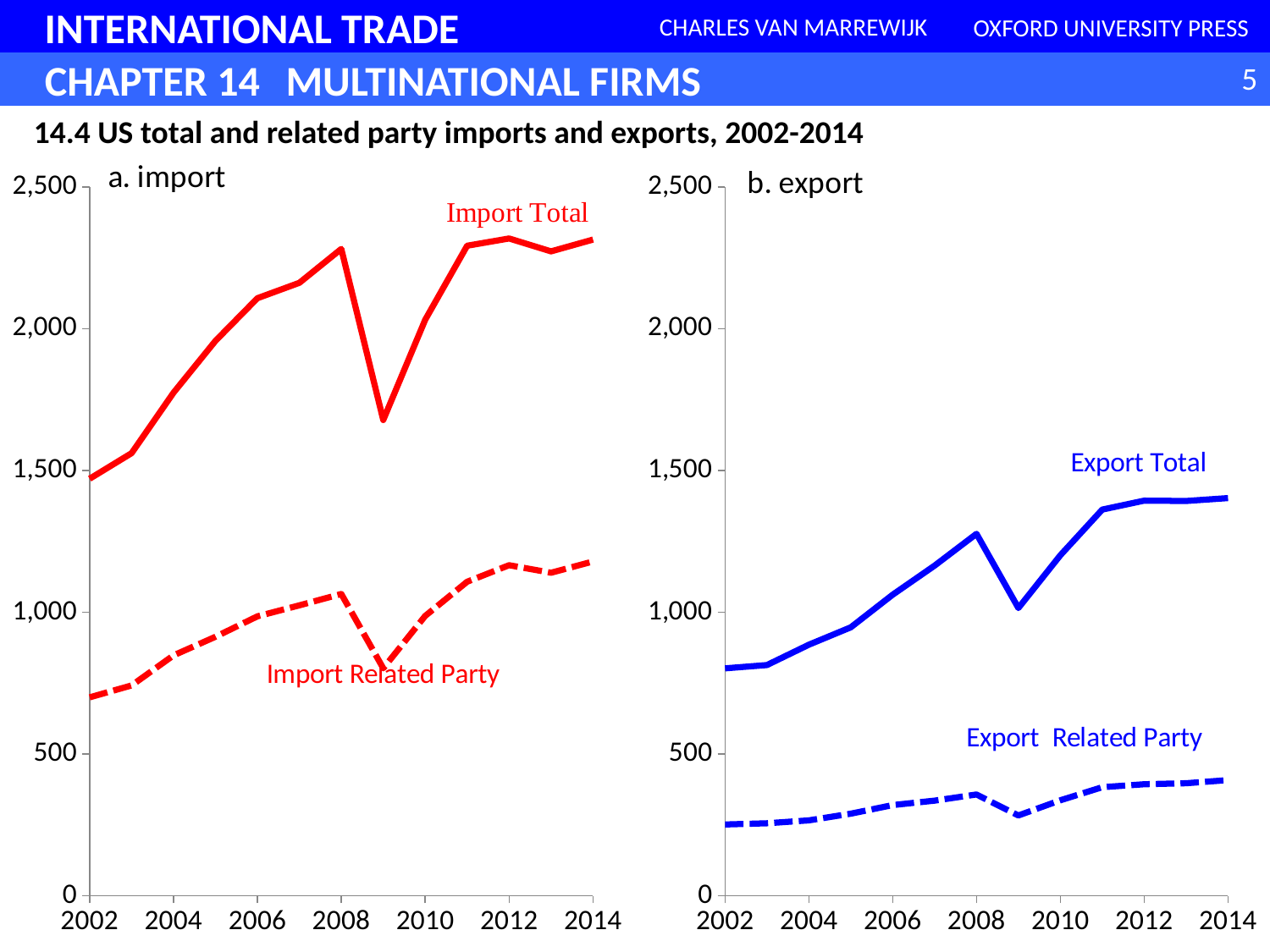
On the 'b. export' chart, is the value of Export Total in 2014 greater or less than 1,500? less On the 'a. import' chart, is the value of Import Total in 2009 greater or less than 2,000? less What is the title of the figure shown on the slide? 14.4 US total and related party imports and exports, 2002-2014 On the 'b. export' chart, is the value of Export Total in 2008 greater or less than 1,000? greater How many series are plotted on the 'b. export' chart? 2 On the 'b. export' chart, in which year is Export Total at its lowest? 2002 On the 'a. import' chart, which series has the higher values throughout, Import Total or Import Related Party? Import Total On the 'b. export' chart, does Export Related Party generally rise or fall from 2002 to 2014? rise What kind of chart is the 'a. import' chart? line chart On the 'a. import' chart, in which year is Import Total at its lowest? 2002